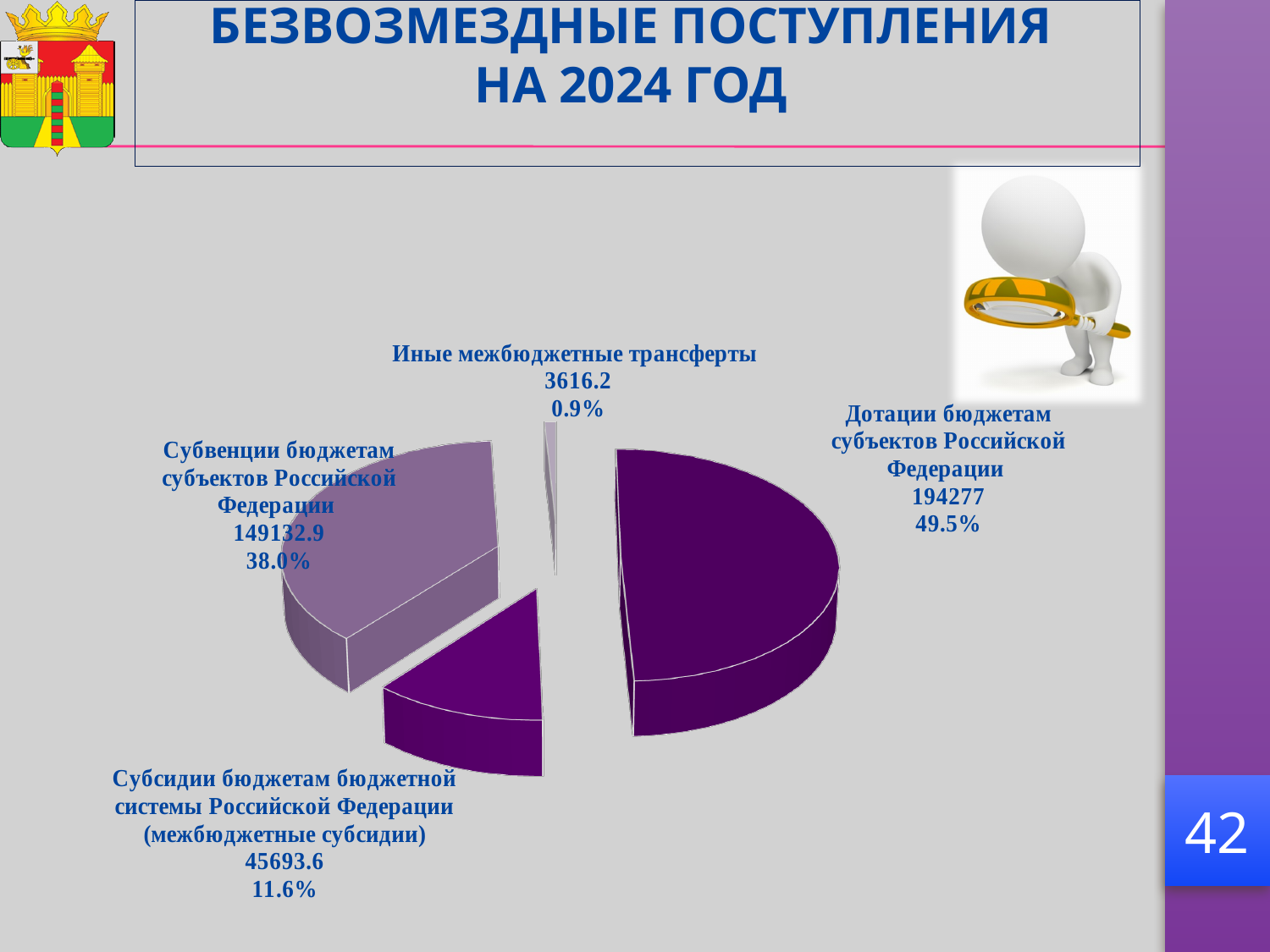
What share of the pie does "Субсидии бюджетам бюджетной системы Российской Федерации (межбюджетные субсидии)" represent? 11.6% What is the value for "Дотации бюджетам субъектов Российской Федерации"? 194277 What is the value for "Субсидии бюджетам бюджетной системы Российской Федерации (межбюджетные субсидии)"? 45693.6 How many slices does the pie chart have? 4 What is the value for "Субвенции бюджетам субъектов Российской Федерации"? 149132.9 What is the title of the slide containing the pie chart? БЕЗВОЗМЕЗДНЫЕ ПОСТУПЛЕНИЯ НА 2024 ГОД What is the difference between the values for "Дотации бюджетам субъектов Российской Федерации" and "Субвенции бюджетам субъектов Российской Федерации"? 45144.1 Which category has the smallest slice of the pie? Иные межбюджетные трансферты Which category has the largest slice of the pie? Дотации бюджетам субъектов Российской Федерации What is the value for "Иные межбюджетные трансферты"? 3616.2 What share of the pie does "Дотации бюджетам субъектов Российской Федерации" represent? 49.5% What kind of chart is shown on the slide? Pie chart